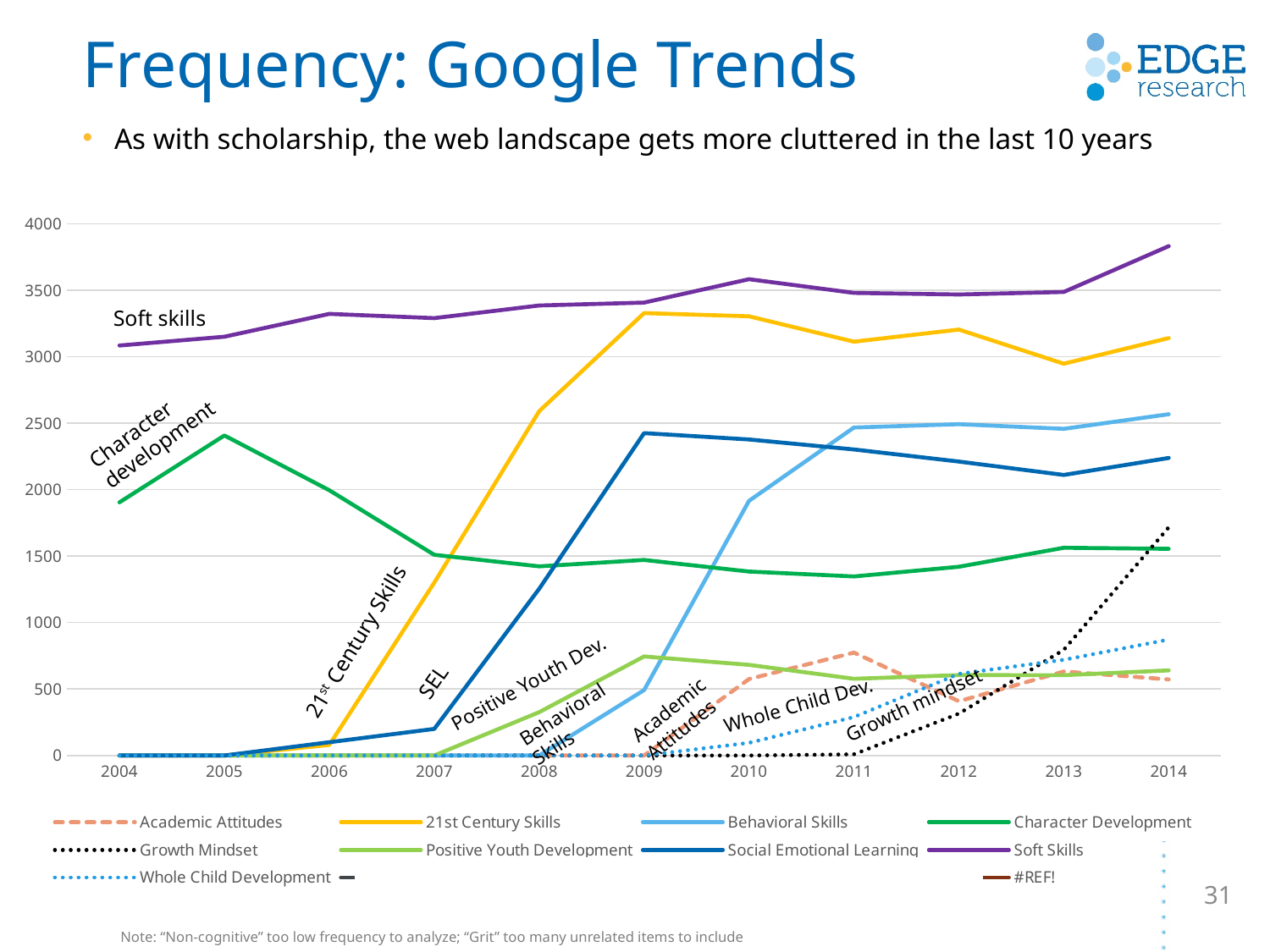
Is the value for Social Emotional Learning in 2009 greater or less than 2000? greater What colour is the Soft Skills line? purple Does the Character Development line rise or fall from 2005 to 2007? fall Is the value for 21st Century Skills in 2006 greater or less than 500? less Which series has the highest value in 2014? Soft Skills Is the value for Soft Skills in 2014 greater or less than 3500? greater How many years are shown on the x axis? 11 What kind of chart is shown on the slide? line chart Does the Soft Skills line rise or fall from 2004 to 2014? rise In 2014, which is larger: Behavioral Skills or Social Emotional Learning? Behavioral Skills